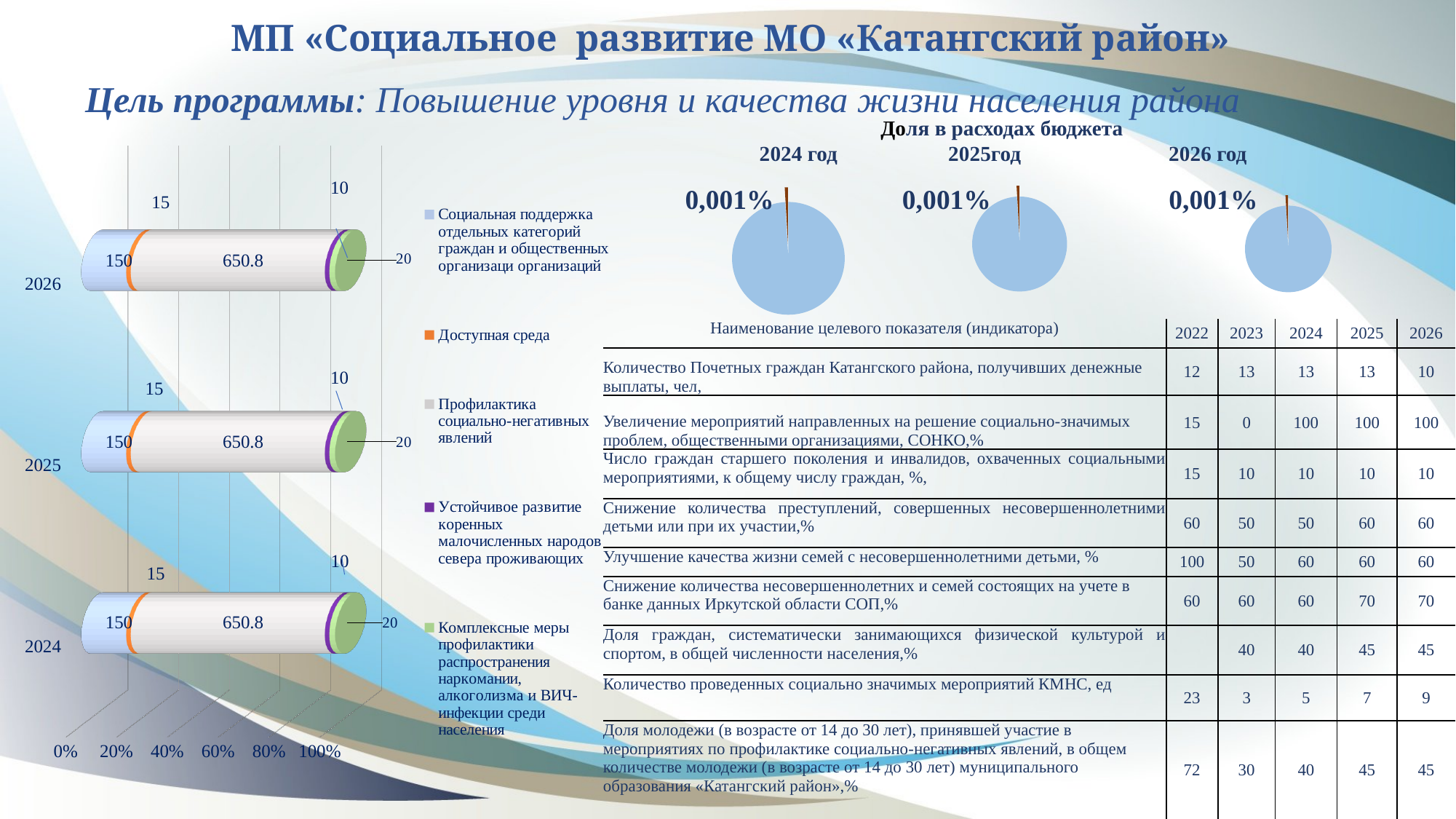
What kind of chart is the chart on the left side of the slide with the years 2024, 2025 and 2026? Stacked bar chart In the stacked bar chart on the left, how many series does the legend list? 5 In the stacked bar chart on the left, what is the value for «Социальная поддержка отдельных категорий граждан и общественных организаций» in 2024? 150 In the pie charts under «Доля в расходах бюджета», what share is shown for 2025? 0,001% In the stacked bar chart on the left, what is the difference between «Профилактика социально-негативных явлений» and «Социальная поддержка отдельных категорий граждан и общественных организаций» in 2026? 500.8 In the stacked bar chart on the left, what is the value for «Комплексные меры профилактики распространения наркомании, алкоголизма и ВИЧ-инфекции среди населения» in 2024? 20 In the stacked bar chart on the left, what is the value for «Профилактика социально-негативных явлений» in 2026? 650.8 In the stacked bar chart on the left, which series has the largest value in 2025? Профилактика социально-негативных явлений In the stacked bar chart on the left, how many years (categories) are shown? 3 In the stacked bar chart on the left, what is the value for «Доступная среда» in 2025? 15